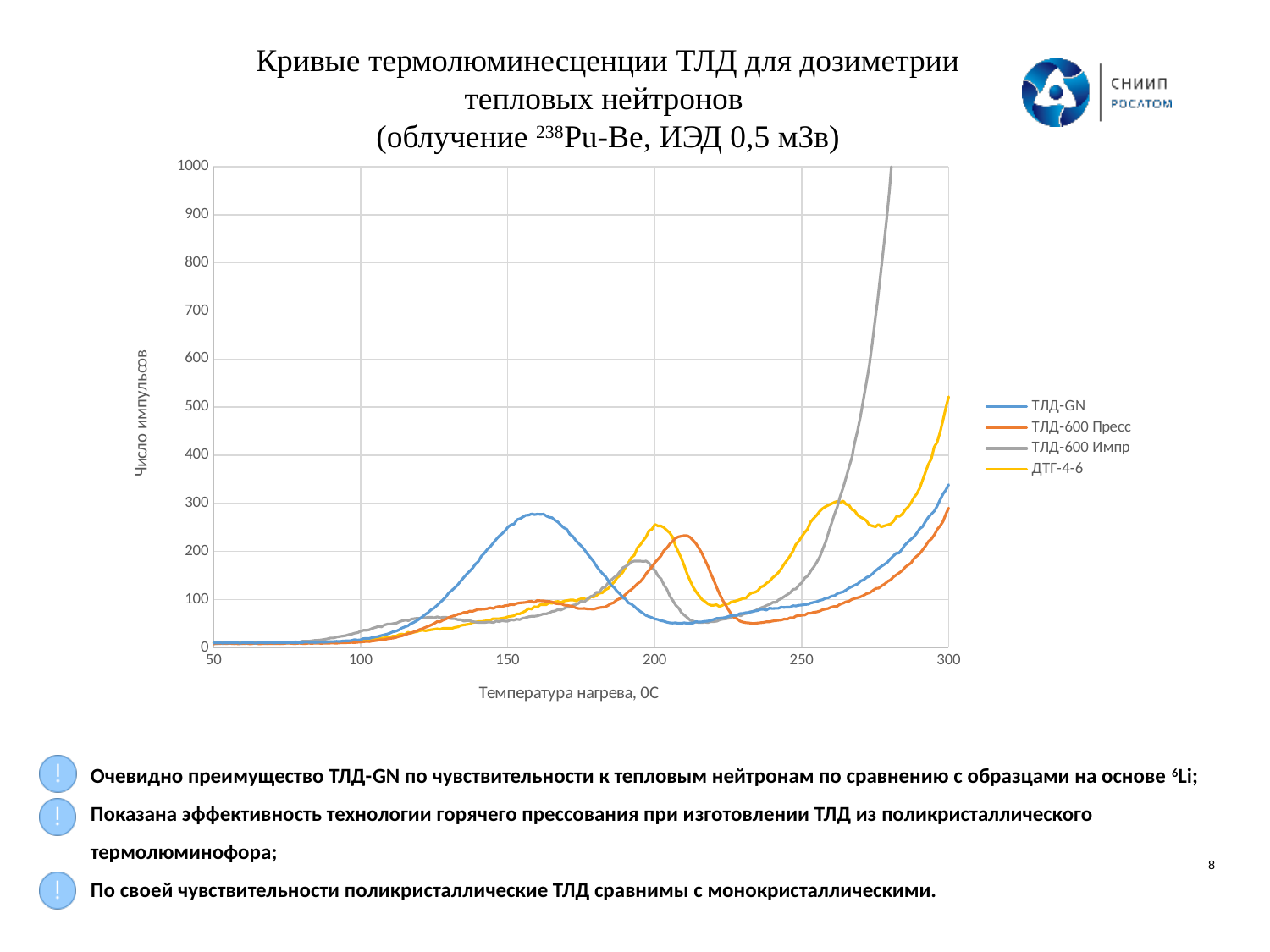
At a heating temperature of 160, which series has the larger value: ТЛД-GN or ТЛД-600 Пресс? ТЛД-GN Is the value for ТЛД-GN at a heating temperature of 100 greater or less than 100? less Is the value for ДТГ-4-6 at a heating temperature of 300 greater or less than 400? greater Which series reaches the highest value on the chart? ТЛД-600 Импр What kind of chart is shown on the slide? line chart Is the value for ТЛД-GN at a heating temperature of 160 greater or less than 200? greater What is the title of the vertical axis? Число импульсов How many series does the legend list? 4 At a heating temperature of 200, which series has the larger value: ДТГ-4-6 or ТЛД-600 Импр? ДТГ-4-6 What are the series names listed in the legend? ТЛД-GN, ТЛД-600 Пресс, ТЛД-600 Импр, ДТГ-4-6